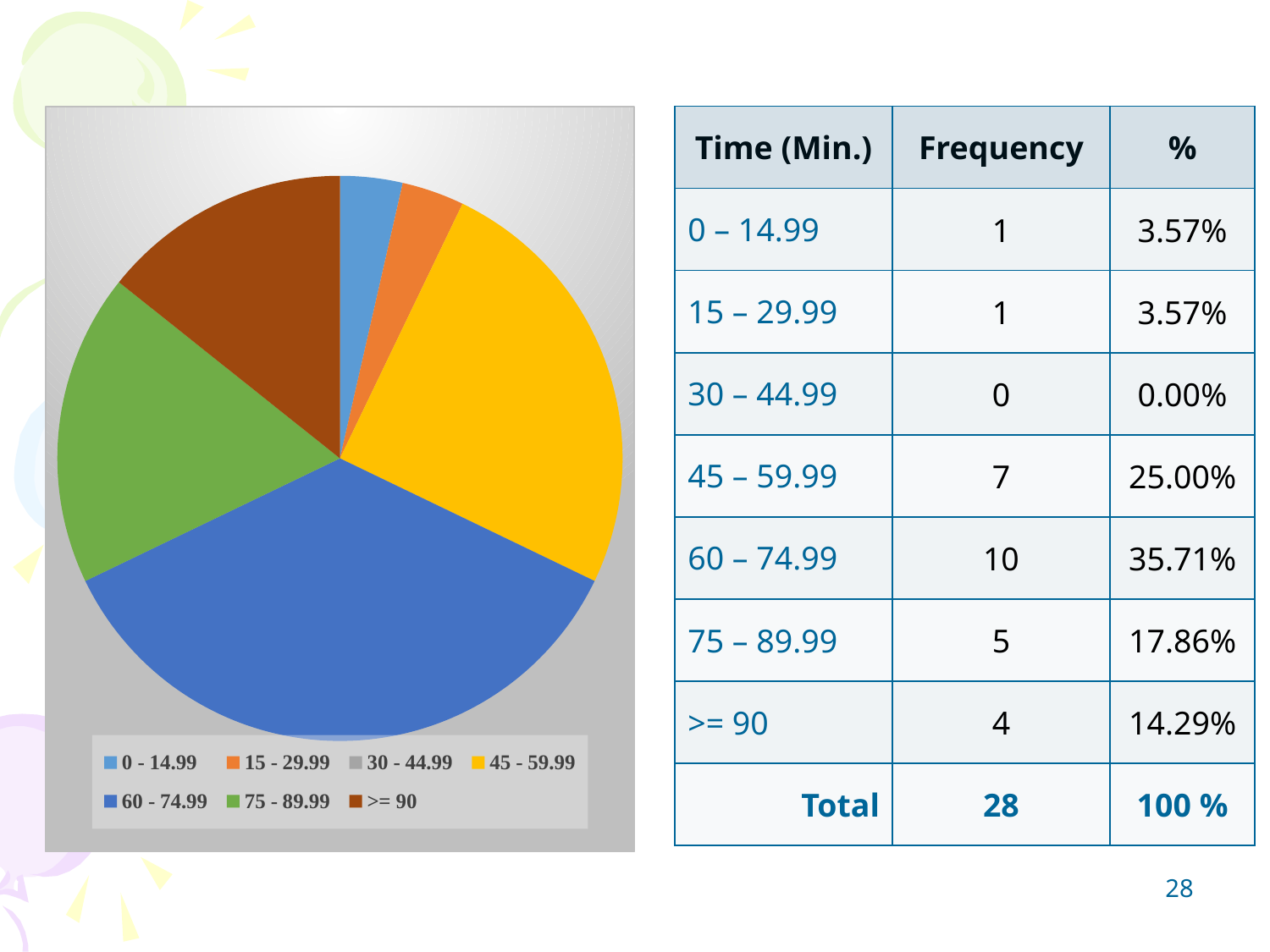
Which time category has the smallest value, according to the table next to the pie chart? 30 – 44.99 Which time category has the largest slice of the pie chart? 60 - 74.99 Which slice is larger in the pie chart: 45 - 59.99 or 75 - 89.99? 45 - 59.99 What share of the pie does the >= 90 category represent, as shown in the table? 14.29% What is the difference in frequency between the 60 – 74.99 and 45 – 59.99 categories? 3 What share of the pie does the 60 – 74.99 category represent, as shown in the table? 35.71% What colour is the 60 - 74.99 slice in the pie chart? blue What is the total frequency across all time categories? 28 What kind of chart is shown on the left of the slide? pie chart How many categories does the pie chart's legend list? 7 What is the frequency for the 45 – 59.99 category in the table? 7 Which slice is larger in the pie chart: 75 - 89.99 or >= 90? 75 - 89.99